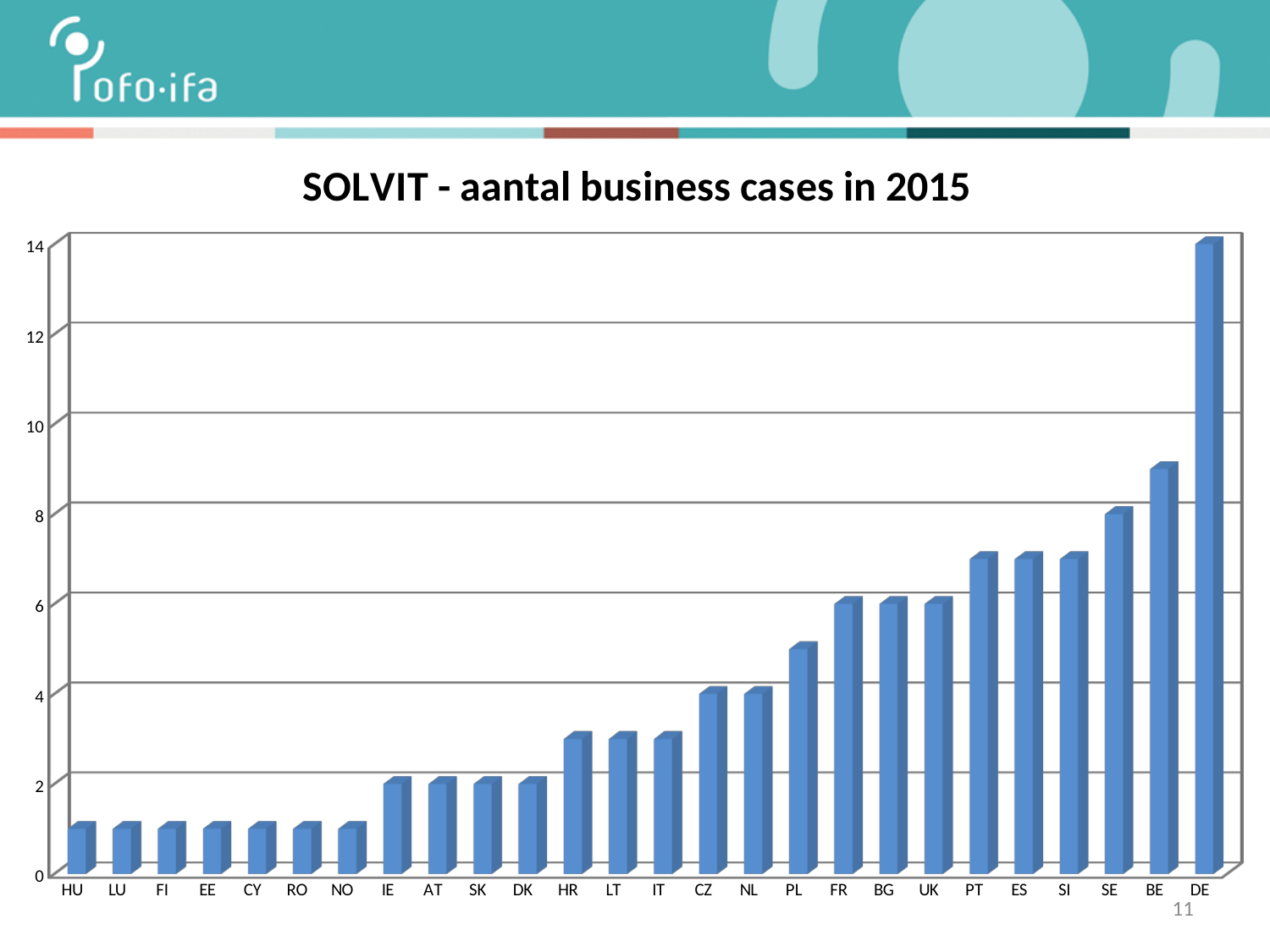
Which country has the highest number of business cases? DE Which is larger, the value for DE or the value for BE? DE Do the values generally rise or fall from left to right along the x axis? rise How many countries are shown on the x axis? 26 What is the value for DE? 14 What is the value for UK? 6 What is the difference between the values for DE and SE? 6 What is the title of the chart? SOLVIT - aantal business cases in 2015 What is the value for SE? 8 Is the value for HR greater or less than 4? less What kind of chart is shown on the slide? bar chart Is the value for BE greater or less than 8? greater